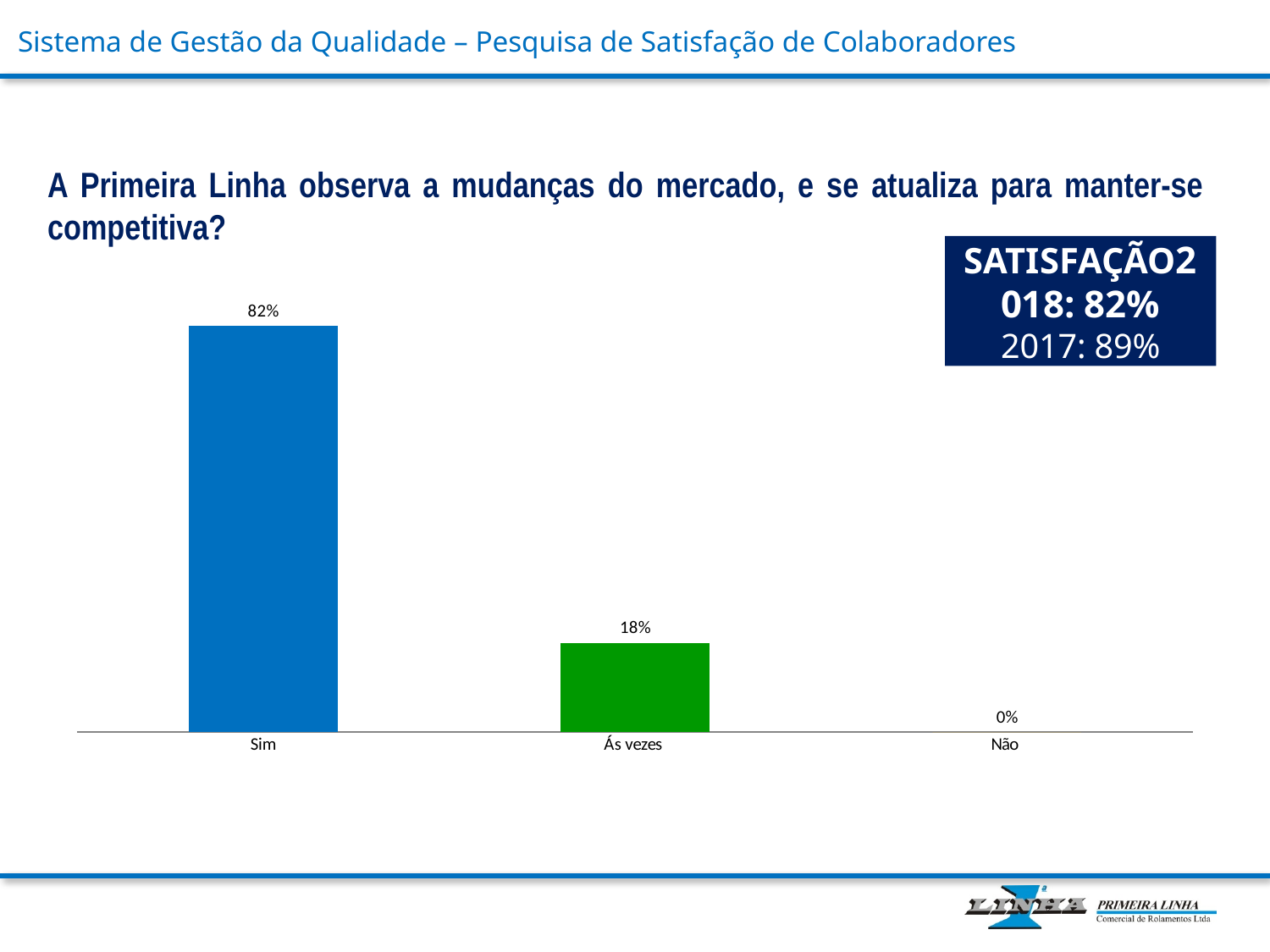
What colour is the bar for "Ás vezes"? Green Do the values rise or fall from left to right along the x axis? Fall What colour is the bar for "Sim"? Blue Which is larger, the value for "Ás vezes" or the value for "Não"? Ás vezes Which category has the lowest value? Não Which category has the highest value? Sim What is the value for "Ás vezes"? 18% What kind of chart is shown on the slide? Bar chart What is the value for "Não"? 0% What is the difference between the values for "Sim" and "Ás vezes"? 64% What is the value for "Sim"? 82% How many categories are shown on the x axis? 3